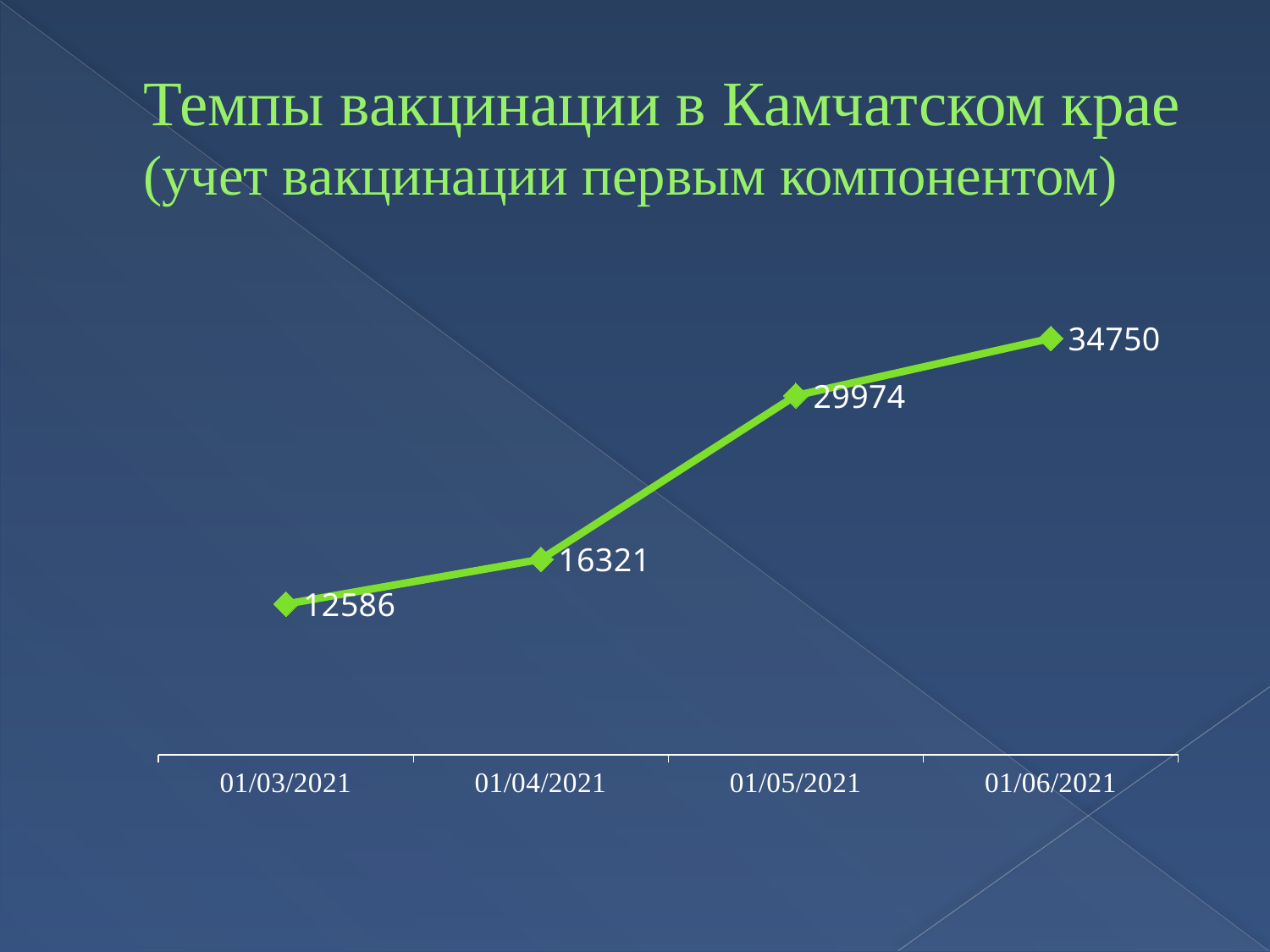
Do the values rise or fall from 01/03/2021 to 01/06/2021? rise Which date has the lowest value? 01/03/2021 How many data points are plotted on the chart? 4 What is the difference between the values for 01/05/2021 and 01/04/2021? 13653 What is the difference between the values for 01/06/2021 and 01/03/2021? 22164 Which is larger, the value for 01/04/2021 or the value for 01/05/2021? 01/05/2021 What is the value for 01/05/2021? 29974 What is the value for 01/04/2021? 16321 What kind of chart is shown on the slide? line chart What is the value for 01/03/2021? 12586 What is the value for 01/06/2021? 34750 Which date has the highest value? 01/06/2021